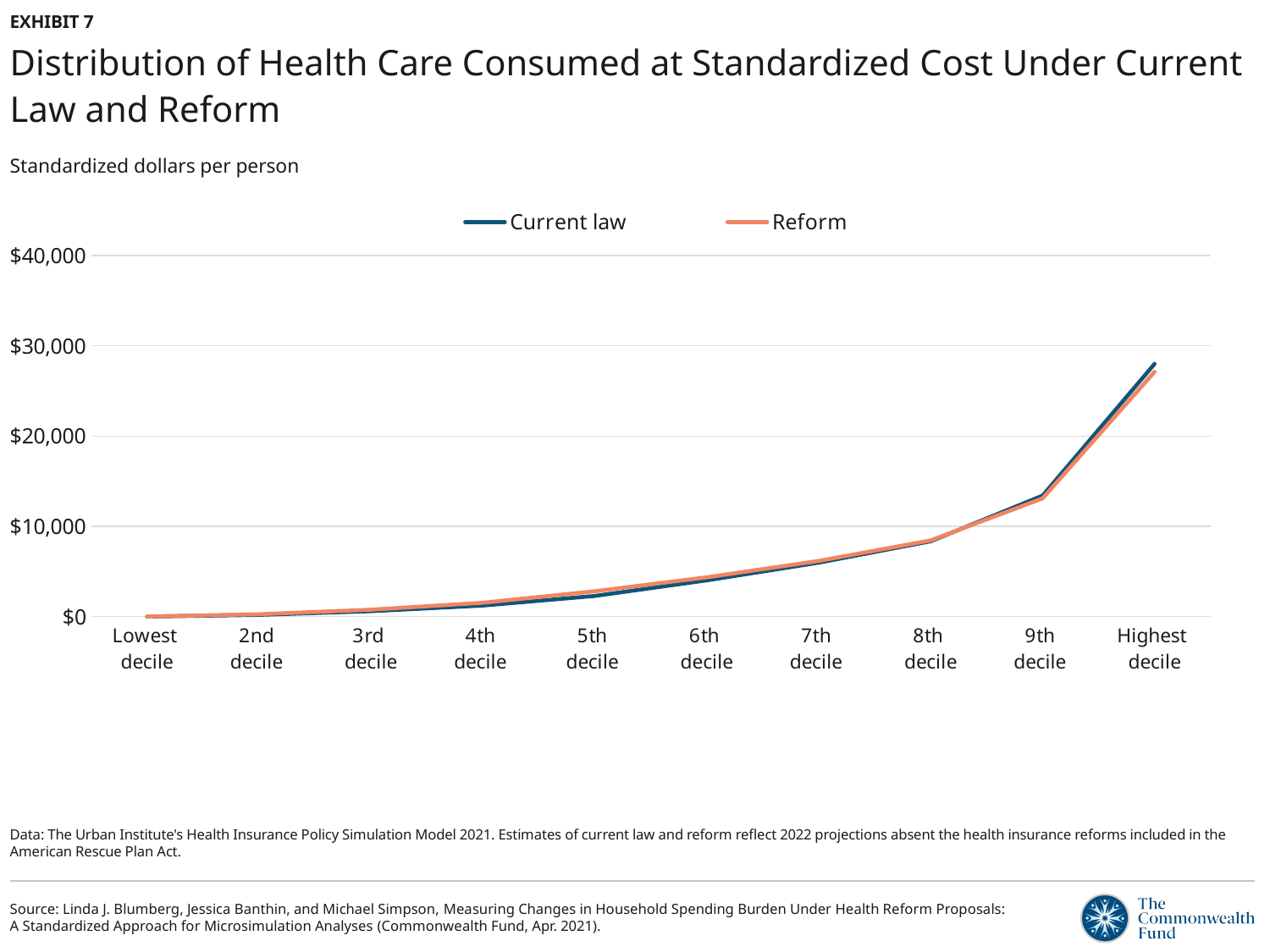
What unit is stated in the subtitle below the chart title? Standardized dollars per person Which decile has the highest value for Current law? Highest decile Do the values for Current law rise or fall from the Lowest decile to the Highest decile? rise Is the Reform value for the Highest decile greater or less than $30,000? less Is the Reform value for the 8th decile greater or less than $10,000? less Is the Current law value for the Highest decile greater or less than $20,000? greater What kind of chart is shown on the slide? line chart How many deciles are plotted along the x axis? 10 Which decile has the lowest value for Reform? Lowest decile Which is larger for Current law: the value for the 9th decile or the Highest decile? Highest decile How many series does the legend list? 2